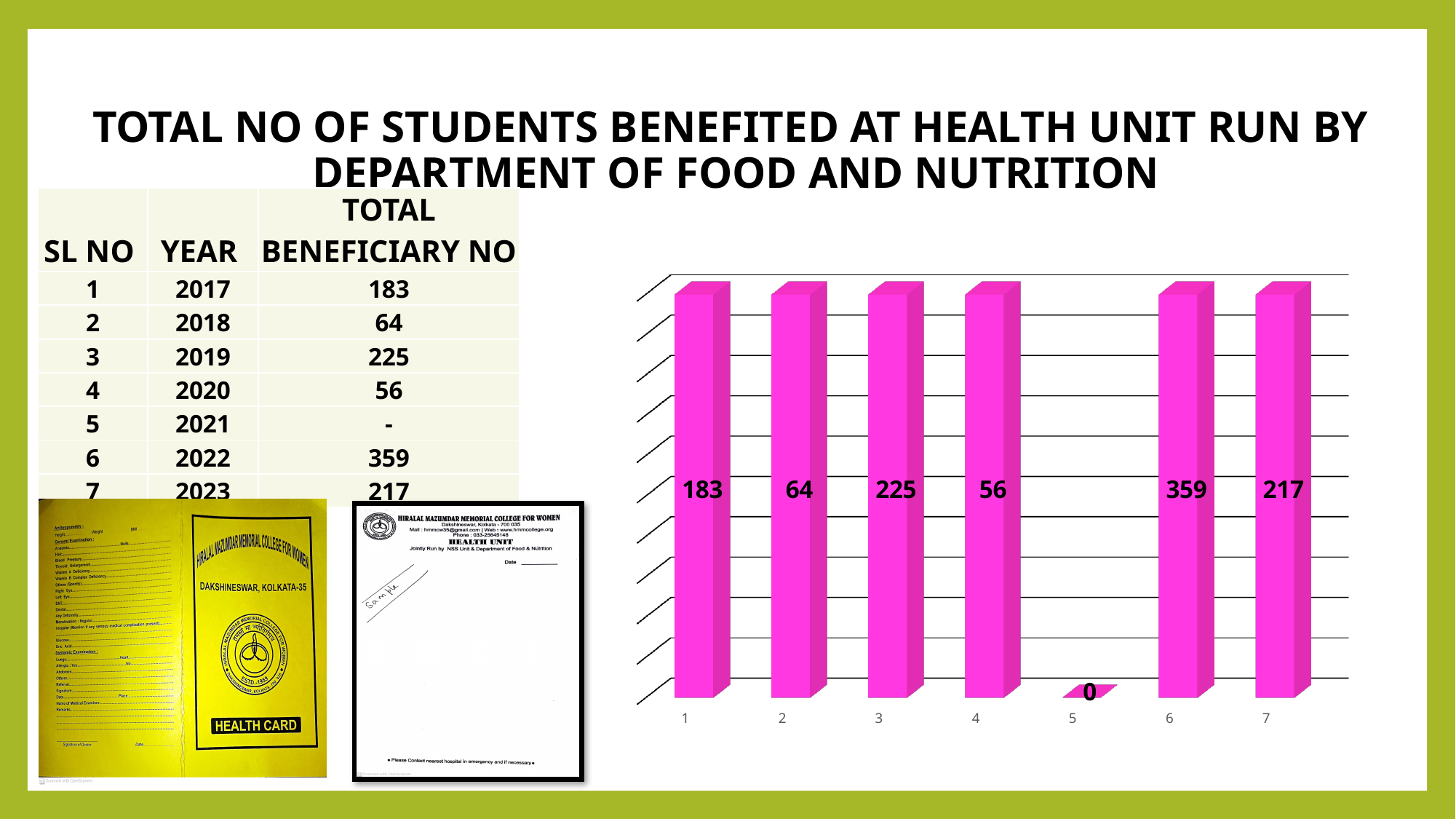
What is the data label on the bar for category 1 in the chart? 183 What is the difference between the labelled values for category 3 and category 2? 161 What type of chart is shown on the slide? bar chart What is the data label for category 7 in the chart? 217 Based on the data labels, which is larger: the value for category 1 or the value for category 4? category 1 How many categories are shown on the x axis of the chart? 7 According to the data labels, which category has the lowest value? 5 What is the difference between the labelled values for category 6 and category 7? 142 What value is labelled on the bar for category 4? 56 According to the data labels, which category has the highest value? 6 What value is shown for category 6 in the bar chart? 359 What value is shown for category 5 in the chart? 0